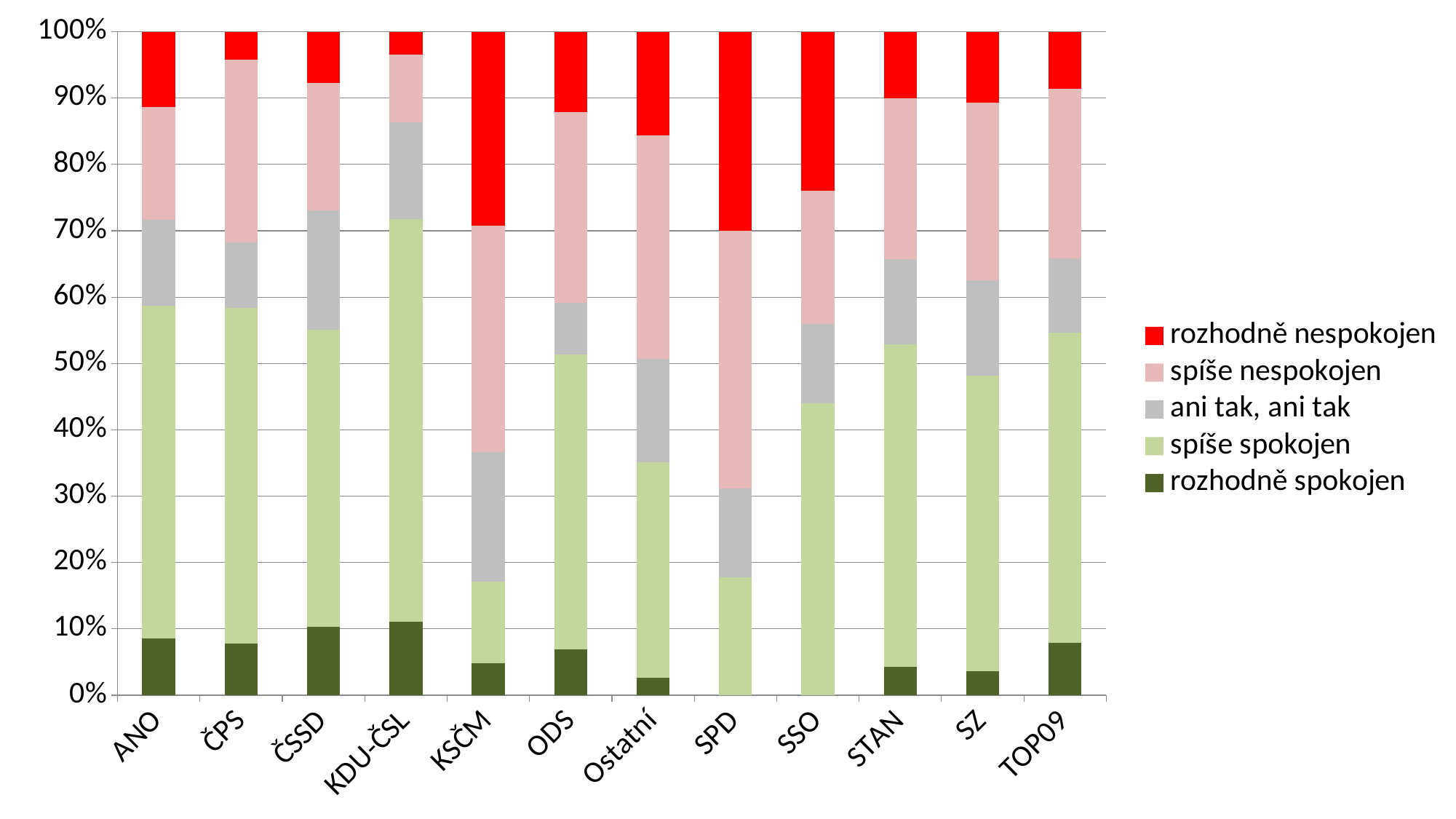
What kind of chart is shown on the slide? Stacked bar chart Is the 'rozhodně nespokojen' segment larger for SPD or for ANO? SPD Is the 'rozhodně spokojen' segment for Ostatní greater or less than 5%? less How many categories (parties) are shown on the x axis? 12 Which series is shown in bright red? rozhodně nespokojen Is the 'rozhodně nespokojen' segment for SPD greater or less than 20%? greater Which categories have no visible 'rozhodně spokojen' segment? SPD and SSO Is the 'rozhodně nespokojen' segment for ANO greater or less than 20%? less Which category has the largest 'spíše spokojen' segment? KDU-ČSL How many series does the legend list? 5 Is the 'spíše spokojen' segment larger for KDU-ČSL or for KSČM? KDU-ČSL Which category has the largest 'ani tak, ani tak' segment? KSČM